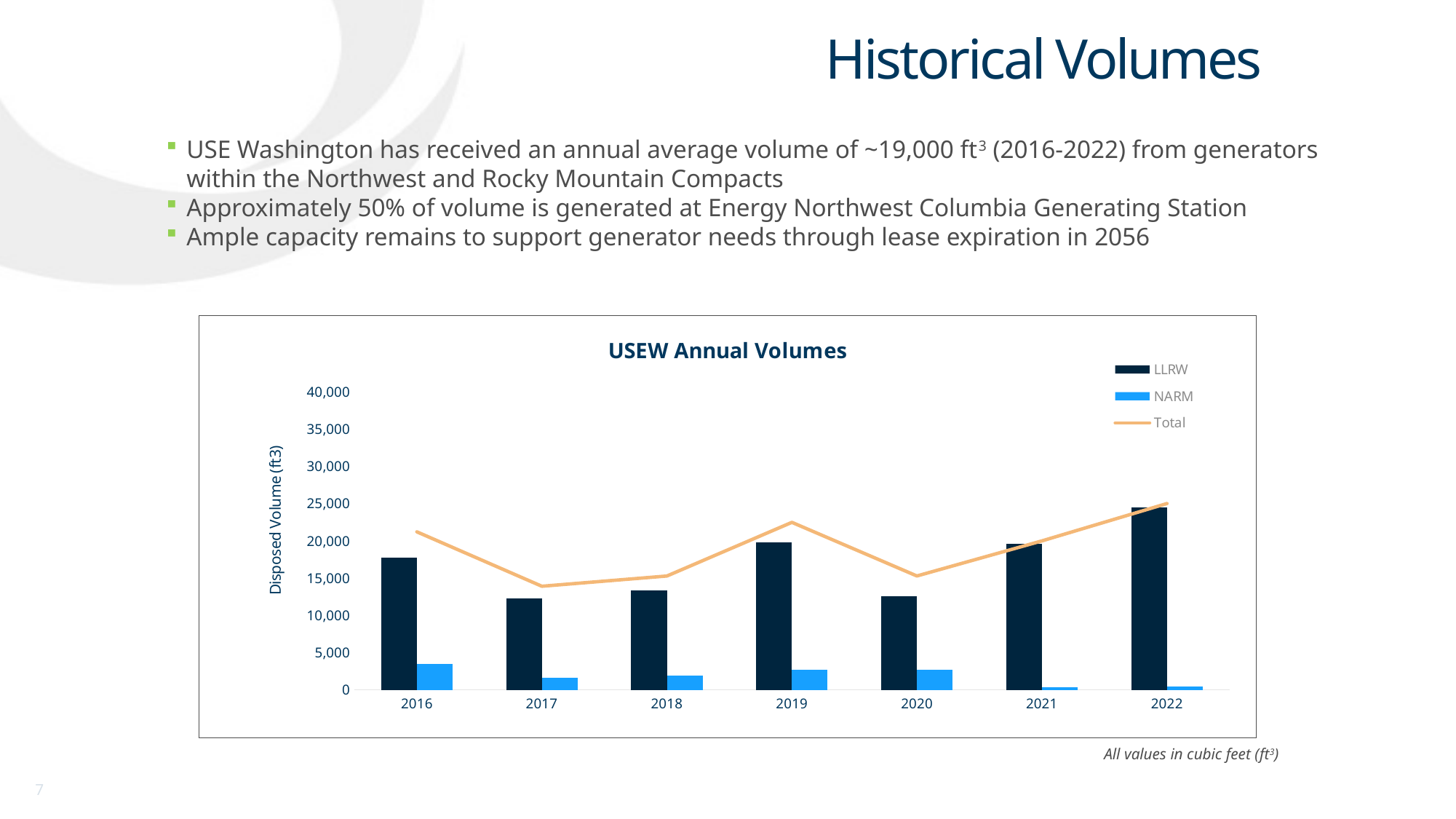
Which year has the highest Total value? 2022 How many years are shown on the x axis of the chart? 7 Is the LLRW value for 2017 greater or less than 15,000? less Which year has the larger LLRW value, 2018 or 2019? 2019 How many series does the chart legend list? 3 Is the Total value for 2019 greater or less than 20,000? greater Does the LLRW value rise or fall from 2020 to 2022? Rise Which year has the highest NARM value? 2016 Is the LLRW value for 2022 greater or less than 20,000? greater What is the title of the chart? USEW Annual Volumes What kind of chart is used for the LLRW and NARM series? Bar chart Which year has the highest LLRW value? 2022